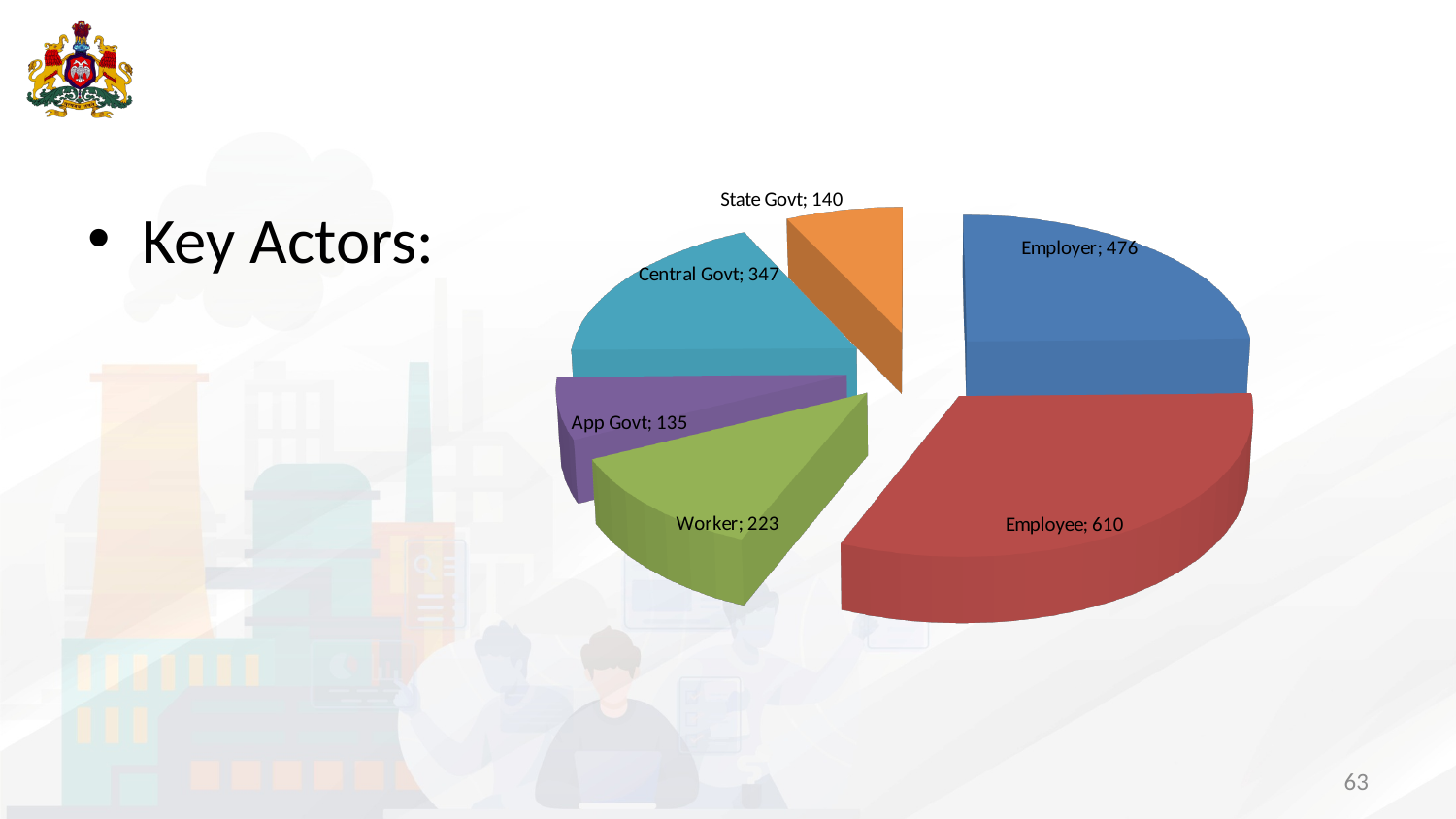
What kind of chart is shown on the slide? Pie chart What is the value for App Govt in the pie chart? 135 How many categories are shown in the pie chart? 6 What is the difference between the values for Central Govt and Worker? 124 What is the value for State Govt in the pie chart? 140 What is the value for Employer in the pie chart? 476 Which is larger, the value for Worker or the value for State Govt? Worker Which category has the largest slice in the pie chart? Employee What is the difference between the values for Employee and Employer? 134 Which category has the smallest slice in the pie chart? App Govt What is the value for Employee in the pie chart? 610 What is the value for Central Govt in the pie chart? 347